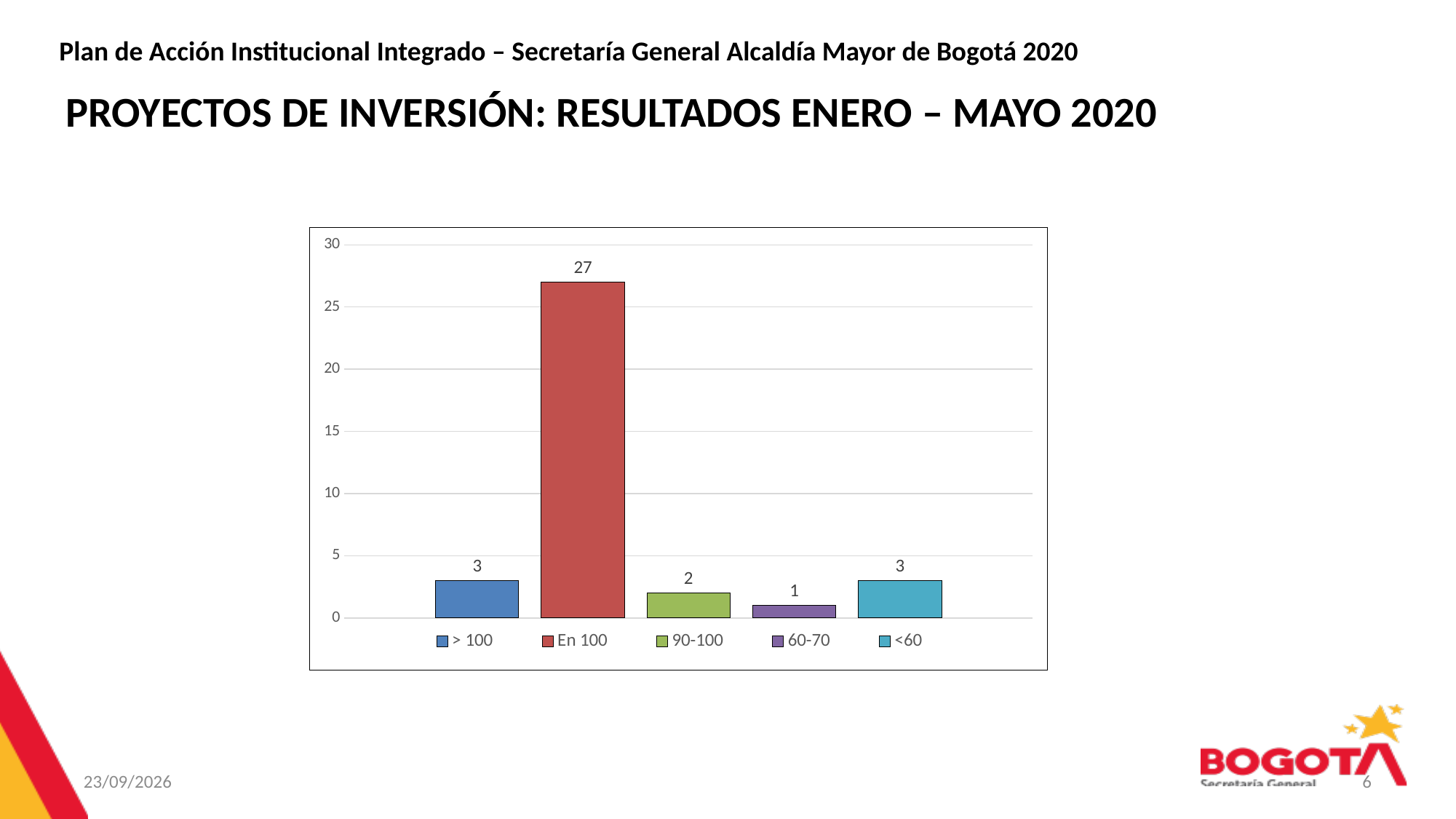
Which is larger, the value for '90-100' or the value for '<60'? <60 Which category has the lowest value? 60-70 What colour is the bar for the 'En 100' category? Red What is the value for the '90-100' category? 2 How many categories are shown in the chart? 5 What is the difference between the values for 'En 100' and '<60'? 24 What is the value for the 'En 100' category? 27 Which category has the highest value? En 100 What kind of chart is shown on the slide? Bar chart Is the value for 'En 100' greater or less than 25? greater What is the value for the '60-70' category? 1 What is the value for the '> 100' category? 3